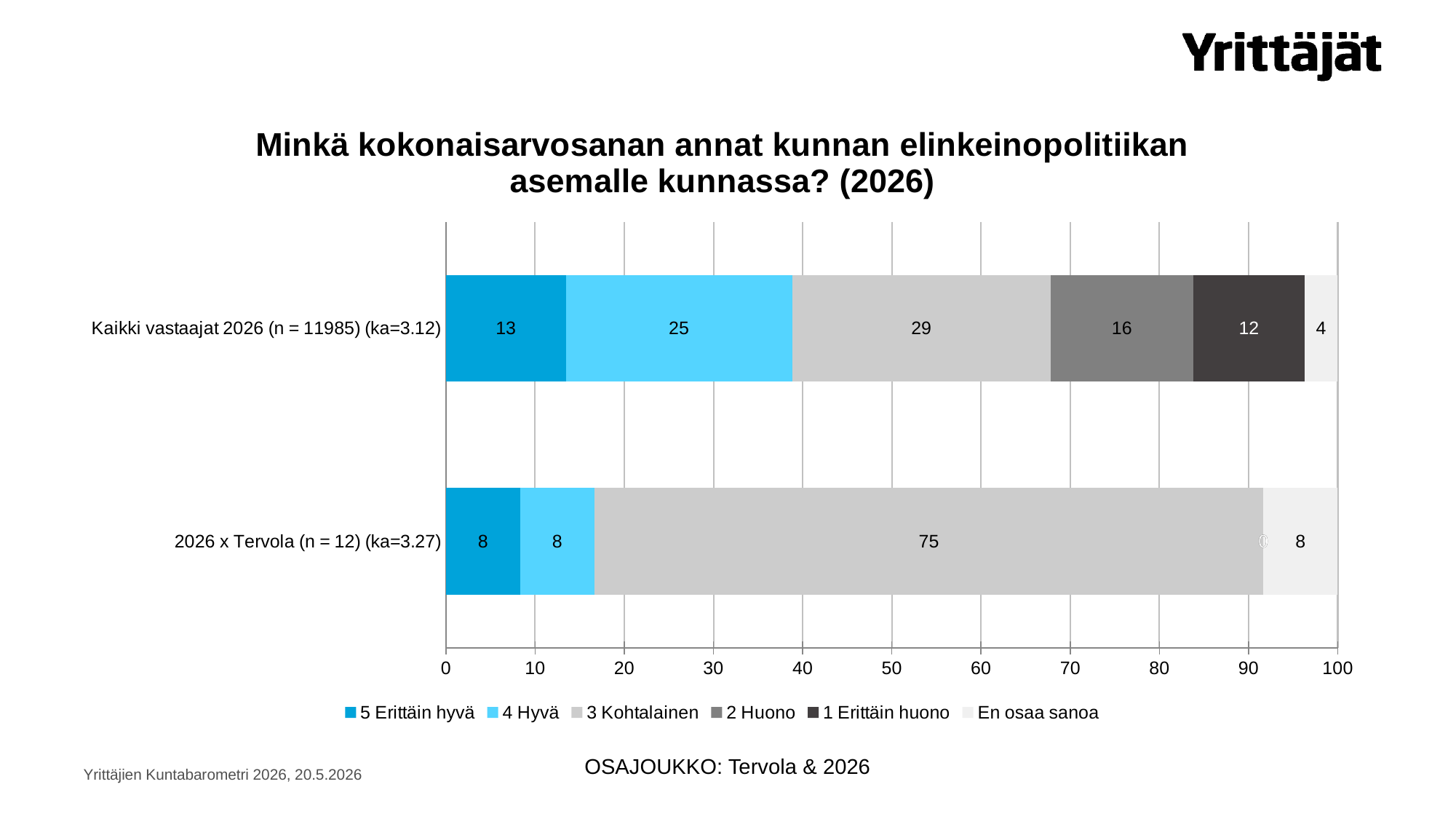
What is the value of "3 Kohtalainen" for "2026 x Tervola (n = 12) (ka=3.27)"? 75 How many series does the legend list? 6 How many categories (bars) are plotted in the chart? 2 What is the value of "4 Hyvä" for "Kaikki vastaajat 2026 (n = 11985) (ka=3.12)"? 25 What is the difference between the "3 Kohtalainen" values for "2026 x Tervola (n = 12) (ka=3.27)" and "Kaikki vastaajat 2026 (n = 11985) (ka=3.12)"? 46 What is the value of "1 Erittäin huono" for "Kaikki vastaajat 2026 (n = 11985) (ka=3.12)"? 12 What kind of chart is shown on the slide? stacked bar chart Which series has the highest value for "Kaikki vastaajat 2026 (n = 11985) (ka=3.12)"? 3 Kohtalainen Which is larger: the "5 Erittäin hyvä" value for "Kaikki vastaajat 2026 (n = 11985) (ka=3.12)" or for "2026 x Tervola (n = 12) (ka=3.27)"? Kaikki vastaajat 2026 (n = 11985) (ka=3.12) Which series has the lowest value for "Kaikki vastaajat 2026 (n = 11985) (ka=3.12)"? En osaa sanoa What is the value of "5 Erittäin hyvä" for "2026 x Tervola (n = 12) (ka=3.27)"? 8 What is the title of the chart? Minkä kokonaisarvosanan annat kunnan elinkeinopolitiikan asemalle kunnassa? (2026)